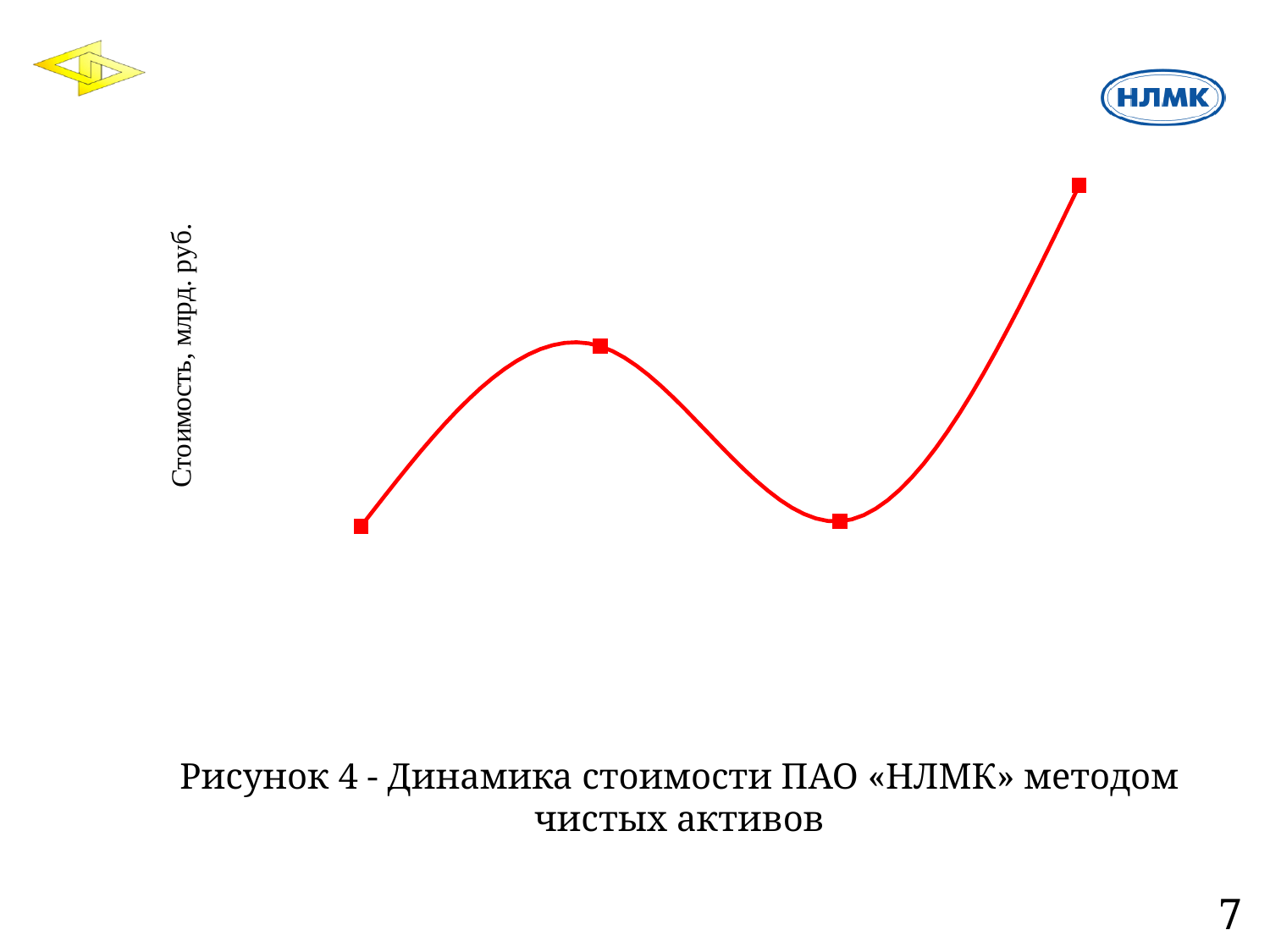
What is the label of the vertical axis? Стоимость, млрд. руб. What is the caption of the figure? Рисунок 4 - Динамика стоимости ПАО «НЛМК» методом чистых активов Is the value of the second point larger or smaller than the value of the first point? larger Does the line end higher or lower than it starts? higher How many data points are plotted on the line? 4 Is the value of the third point larger or smaller than the value of the second point? smaller Is the value of the fourth point larger or smaller than the value of the second point? larger Does the line rise or fall between the third and fourth points? rises What kind of chart is shown on the slide? line chart Which data point has the highest value: the first, second, third or fourth? the fourth